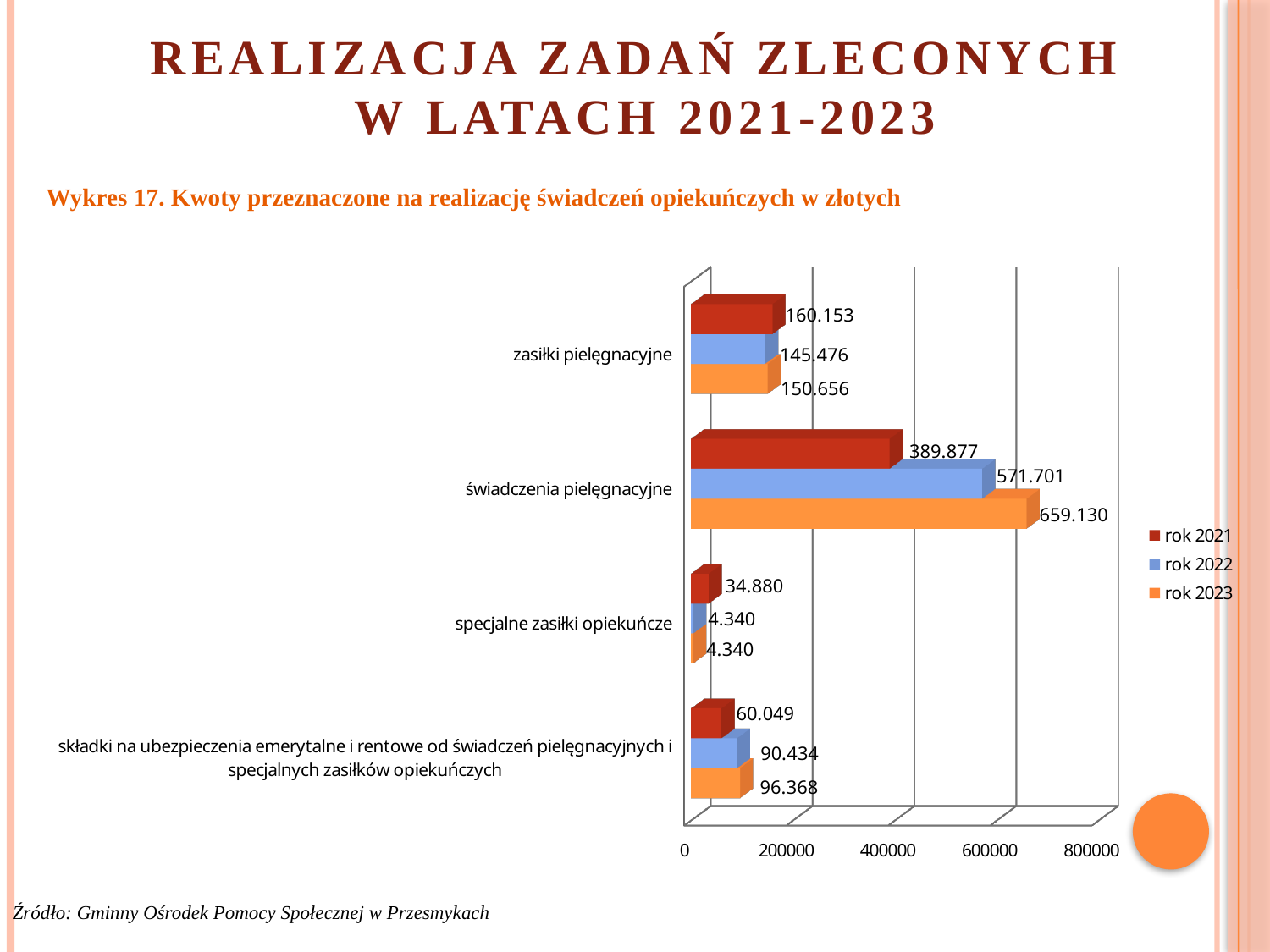
Which category has the lowest value in rok 2023? specjalne zasiłki opiekuńcze What is the title of the chart (Wykres 17)? Kwoty przeznaczone na realizację świadczeń opiekuńczych w złotych What is the value for świadczenia pielęgnacyjne in rok 2023? 659.130 Which is larger for zasiłki pielęgnacyjne: the rok 2021 value or the rok 2023 value? rok 2021 What is the value for zasiłki pielęgnacyjne in rok 2021? 160.153 Is the rok 2021 value for świadczenia pielęgnacyjne greater or less than 400000? less What kind of chart is shown on the slide? bar chart How many categories are shown on the chart? 4 Which category has the highest value in rok 2022? świadczenia pielęgnacyjne What is the difference between the rok 2023 and rok 2022 values for świadczenia pielęgnacyjne? 87.429 How many series does the legend list? 3 What is the value for specjalne zasiłki opiekuńcze in rok 2022? 4.340